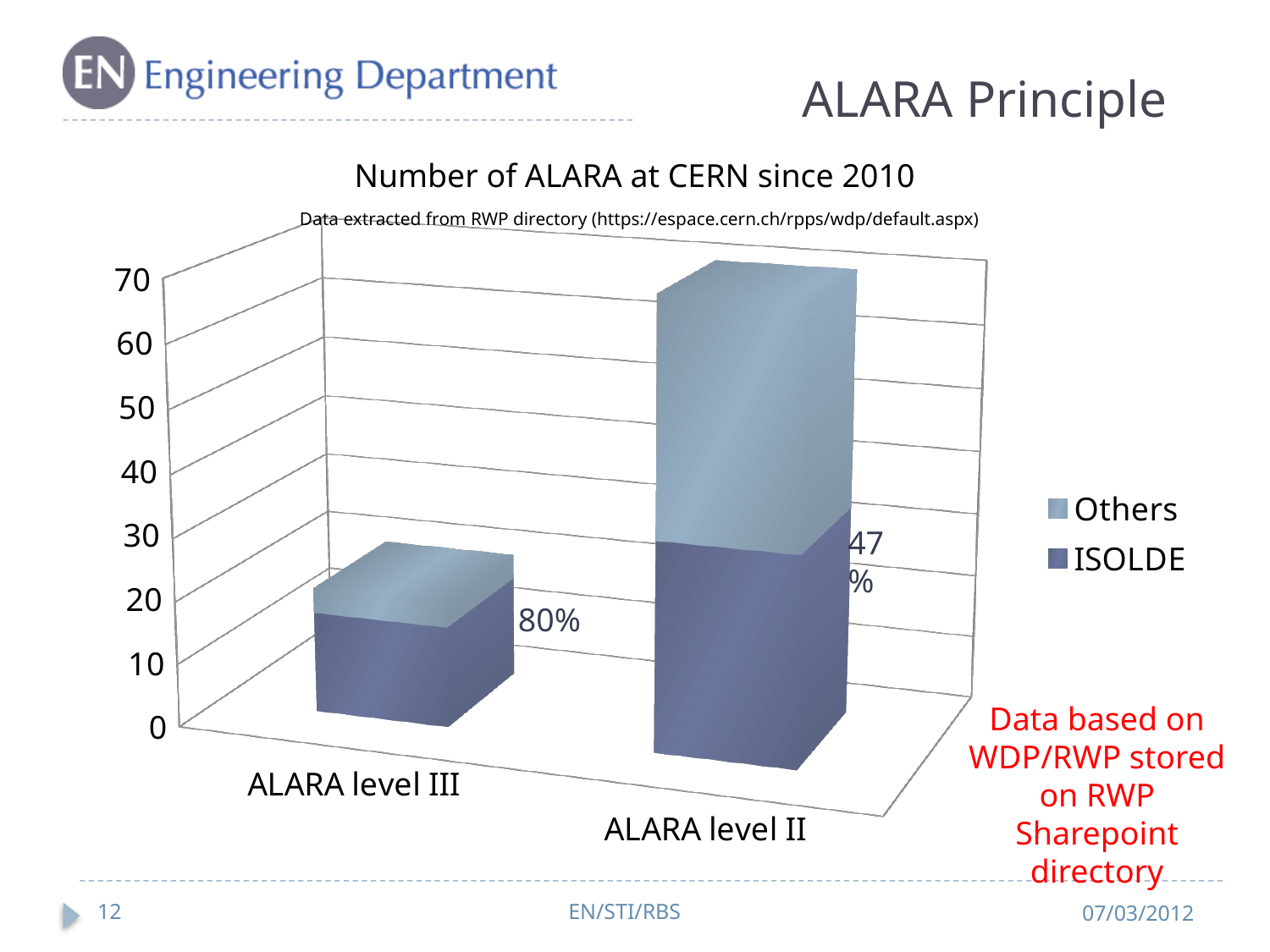
Which category has the tallest stacked bar? ALARA level II How many categories are shown on the x axis of the chart? 2 Is the total value of the ALARA level II bar greater or less than 50? greater What percentage label is shown on the ALARA level III bar? 80% What are the two series listed in the chart legend? Others and ISOLDE Is the total value of the ALARA level III bar greater or less than 30? less What percentage label is shown on the ALARA level II bar? 47% Which category has the shortest stacked bar? ALARA level III What kind of chart is shown on the slide? Stacked bar chart Which percentage label is larger, the one for ALARA level III or the one for ALARA level II? ALARA level III How many series does the chart legend list? 2 What is the title of the chart? Number of ALARA at CERN since 2010